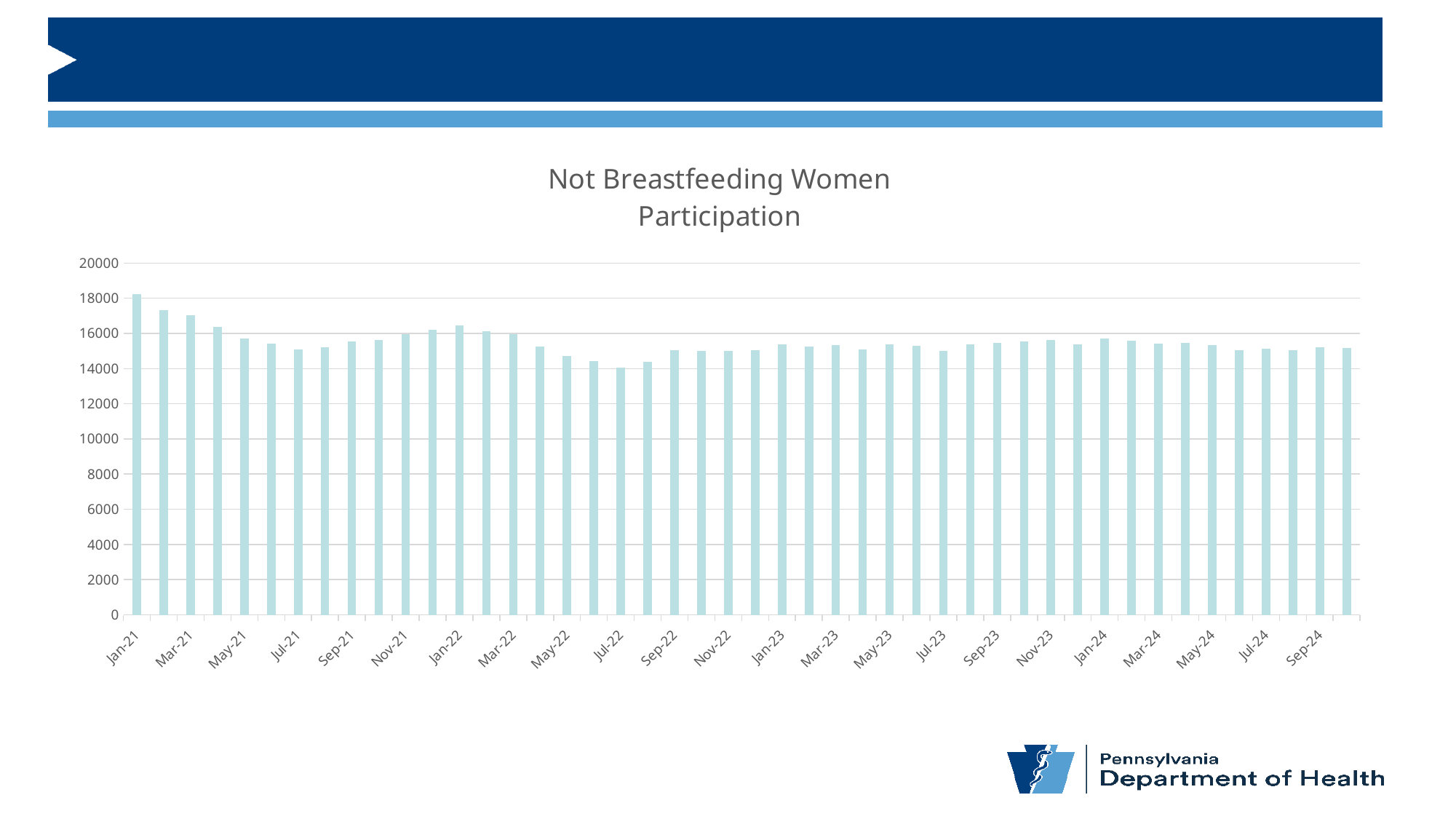
Which month has the lowest Not Breastfeeding Women Participation? Jul-22 Is the value for Mar-21 greater or less than 16000? greater Which month has the highest Not Breastfeeding Women Participation? Jan-21 What is the highest value shown on the vertical axis? 20000 Is the value for Sep-24 greater or less than 14000? greater Which is larger, the value for Jan-21 or the value for Jan-22? Jan-21 What kind of chart is shown on the slide? bar chart Is the value for Jul-22 greater or less than 16000? less What is the title of the chart? Not Breastfeeding Women Participation Which is larger, the value for Jan-22 or the value for Jul-22? Jan-22 Do the values generally rise or fall from Jan-21 to Jul-22? fall